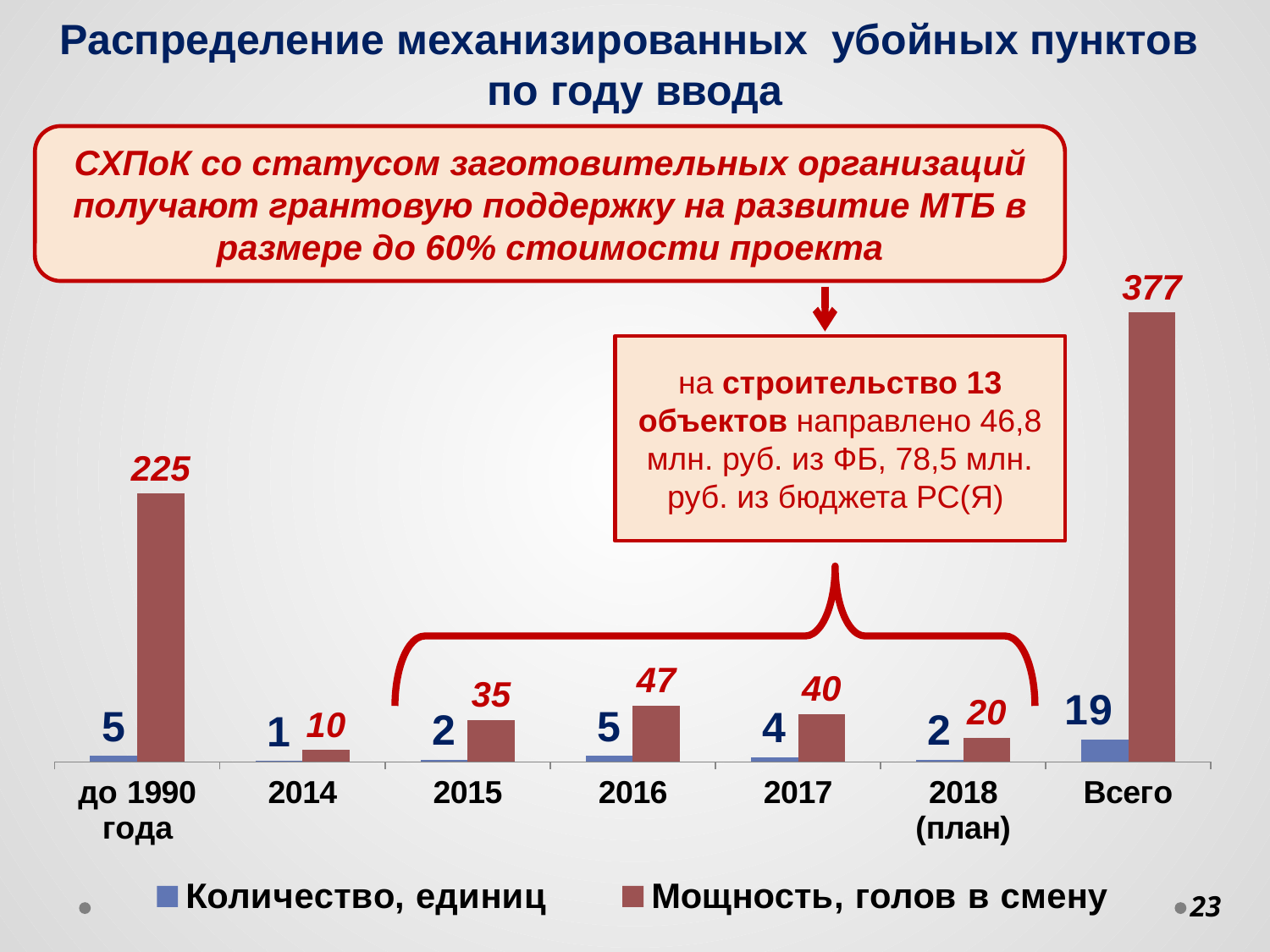
What kind of chart is shown on the slide? bar chart Which category has the lowest "Мощность, голов в смену"? 2014 What is the value of "Мощность, голов в смену" for "до 1990 года"? 225 What is the value of "Количество, единиц" for 2016? 5 How many categories are shown on the x axis? 7 Excluding the "Всего" total, which year has the highest "Мощность, голов в смену"? до 1990 года What is the value of "Мощность, голов в смену" for "2018 (план)"? 20 What is the value of "Количество, единиц" for "Всего"? 19 Which is larger, the "Мощность, голов в смену" for 2017 or for 2016? 2016 What is the difference in "Мощность, голов в смену" between 2016 and 2015? 12 How many series does the legend list? 2 What is the difference in "Количество, единиц" between 2016 and 2014? 4